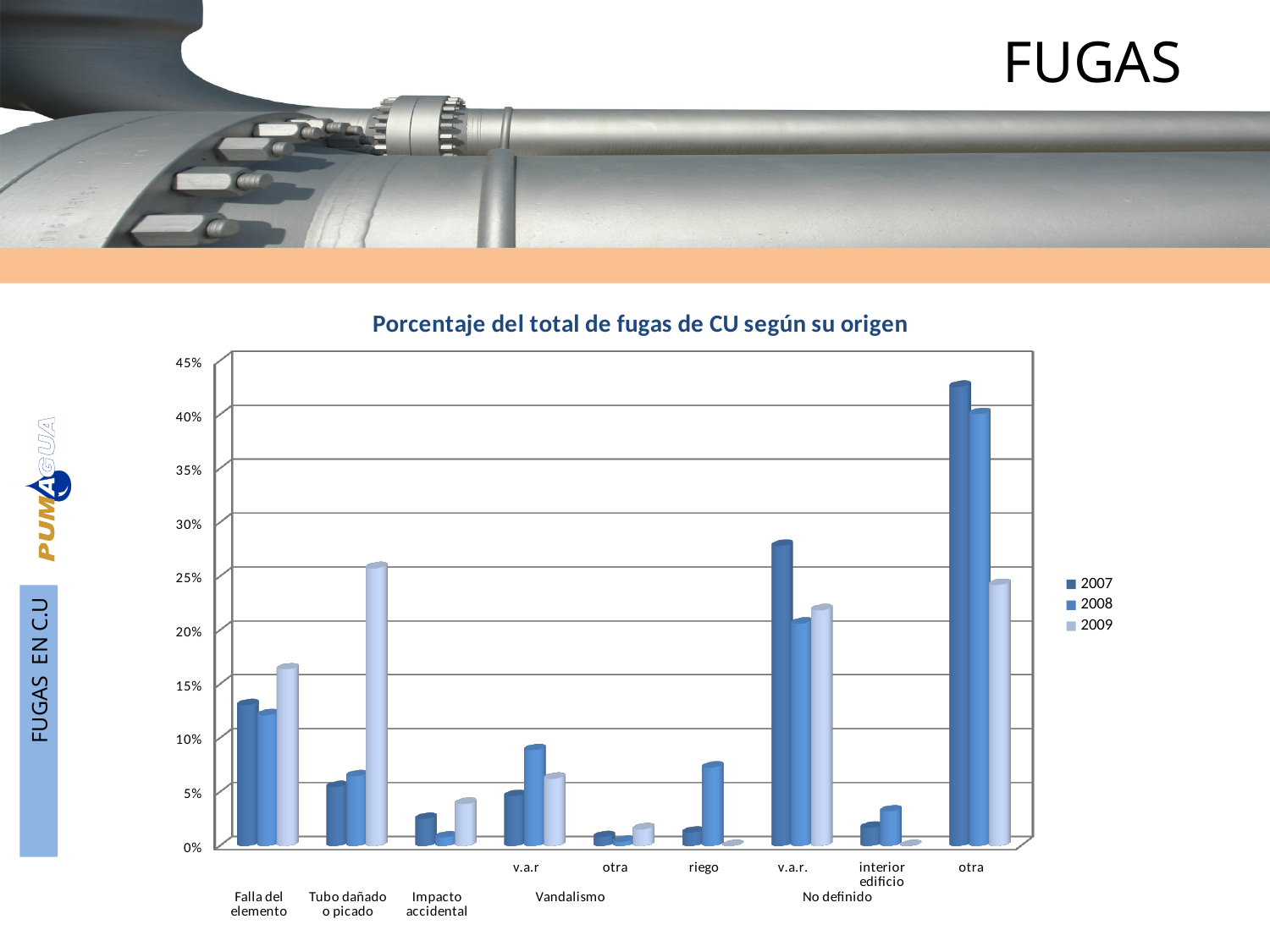
Which category has the highest value for the 2007 series? No definido otra How many origin categories are plotted along the x axis? 9 For Vandalismo v.a.r, which is larger: the 2007 value or the 2008 value? 2008 How many series does the legend list? 3 For Tubo dañado o picado, which is larger: the 2008 value or the 2009 value? 2009 Is the 2009 value for Tubo dañado o picado greater or less than 20%? greater What are the series listed in the legend? 2007, 2008, 2009 Is the 2007 value for No definido v.a.r. greater or less than 25%? greater Is the 2007 value for No definido otra greater or less than 40%? greater For Falla del elemento, which series has the highest value? 2009 What is the title of the chart? Porcentaje del total de fugas de CU según su origen What kind of chart is shown on the slide? bar chart